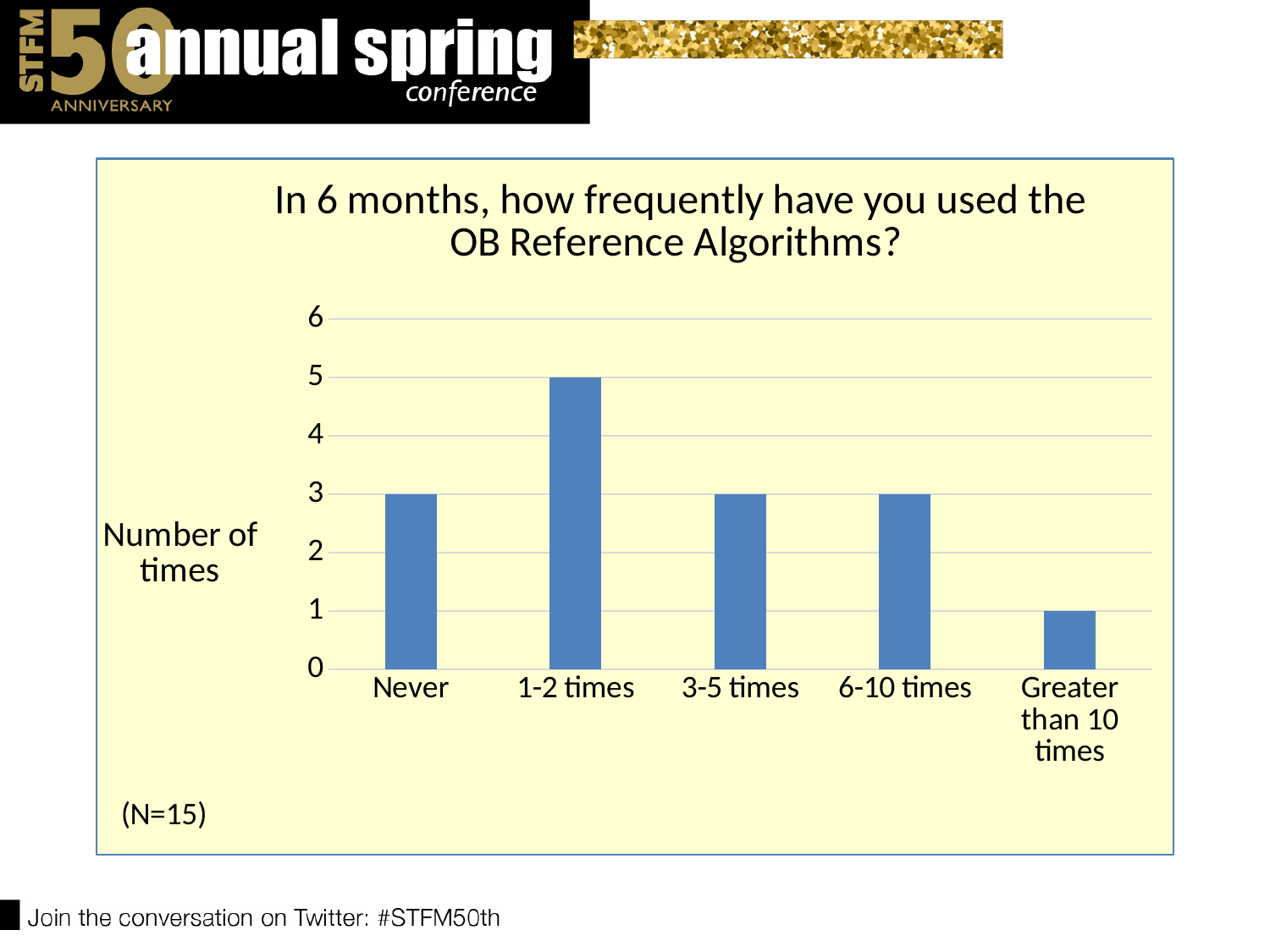
Which is larger, the value for 3-5 times or the value for Greater than 10 times? 3-5 times What kind of chart is shown on the slide? bar chart What is the title of the chart? In 6 months, how frequently have you used the OB Reference Algorithms? Which category has the highest value? 1-2 times What is the value for Never? 3 What is the difference between the values for 1-2 times and 6-10 times? 2 Is the value for 1-2 times greater or less than 4? greater What is the value for Greater than 10 times? 1 What is the label on the vertical axis? Number of times What is the value for 1-2 times? 5 How many categories are shown on the x axis? 5 Which category has the lowest value? Greater than 10 times